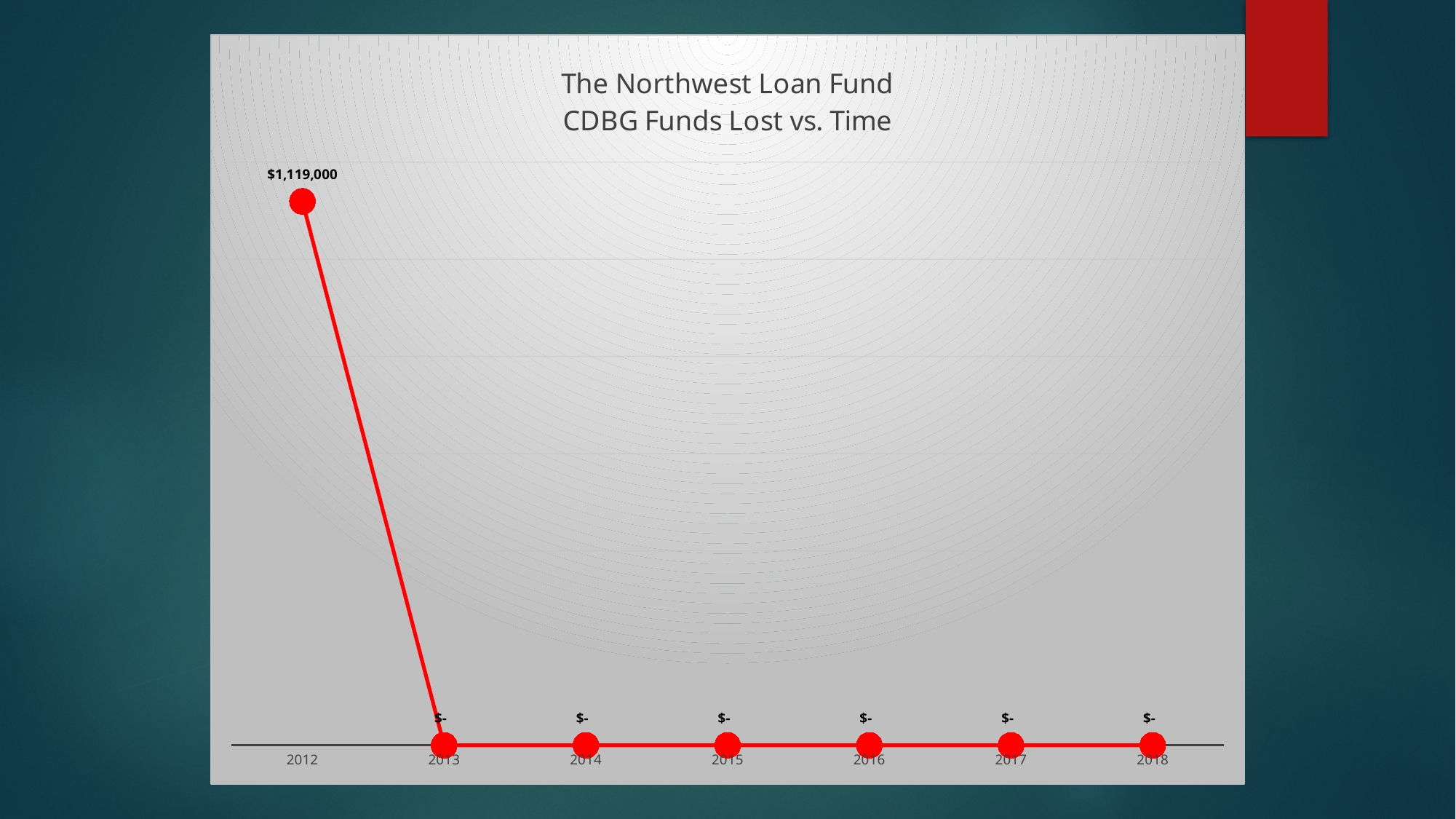
What is the first year shown on the x axis? 2012 What is the value for 2018? $- What is the title of the chart? The Northwest Loan Fund CDBG Funds Lost vs. Time What kind of chart is shown? line chart Which year has the highest value? 2012 Is the value for 2012 larger or smaller than the value for 2013? larger What is the value for 2012? $1,119,000 How many years are plotted on the x axis? 7 What is the value for 2015? $- What colour is the plotted line? red Do the values rise or fall from 2012 to 2013? fall